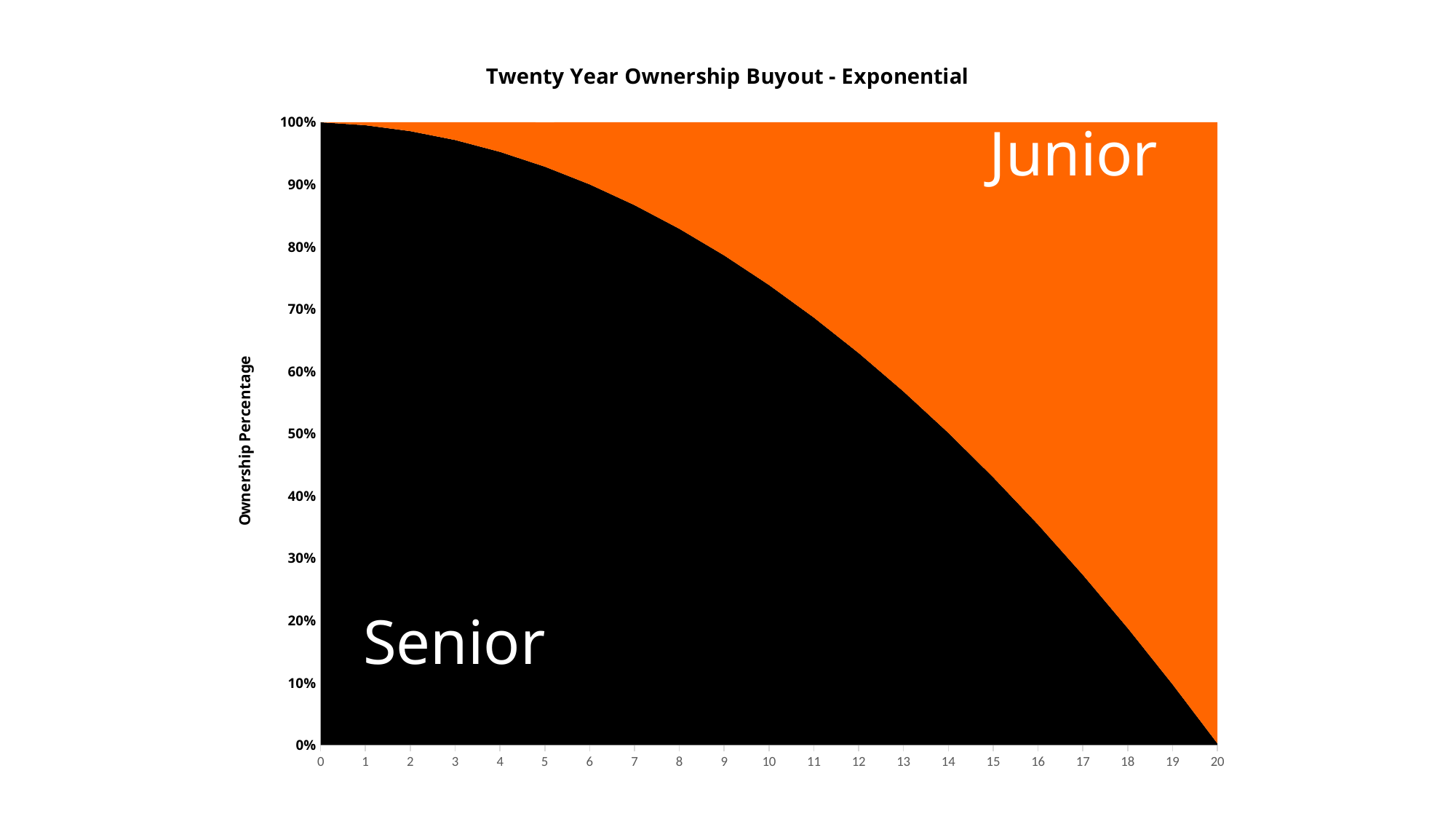
What is the title of the chart? Twenty Year Ownership Buyout - Exponential What is the Senior ownership percentage at year 0? 100% What is the last year shown on the horizontal axis? 20 Is the Senior ownership percentage at year 5 greater or less than 90%? greater Is the Senior ownership percentage at year 18 greater or less than 30%? less What kind of chart is shown on the slide? area chart What is the label of the vertical axis? Ownership Percentage Does the Senior ownership percentage rise or fall as the years increase? fall Does the Junior ownership percentage rise or fall as the years increase? rise How many series are shown in the chart? 2